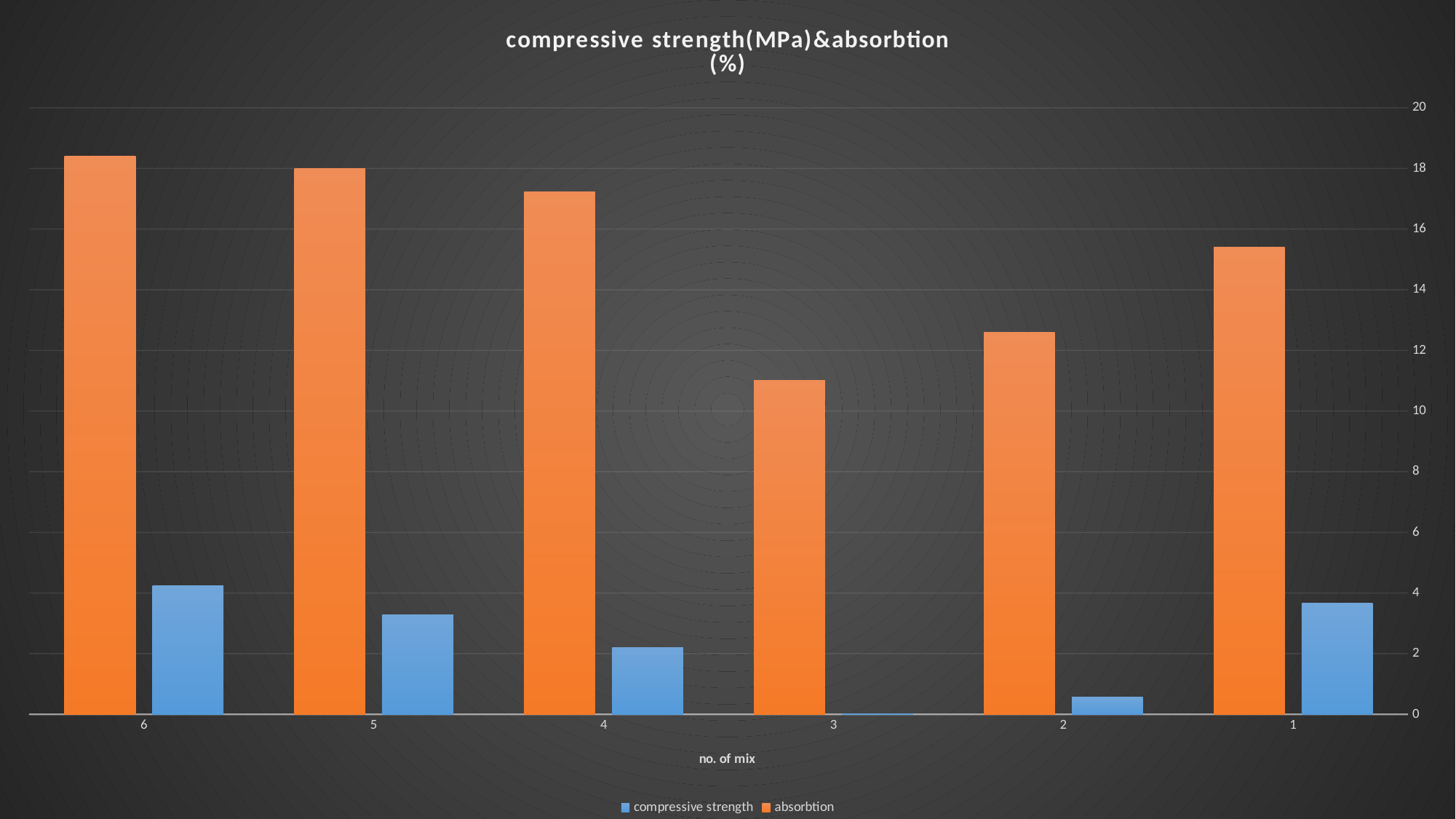
Is the absorbtion value for mix 3 greater or less than 12? less What kind of chart is shown on the slide? bar chart Is the compressive strength value for mix 4 greater or less than 3? less How many series does the legend list? 2 Which mix number has the highest compressive strength? 6 Which has the larger absorbtion value, mix 1 or mix 2? mix 1 Which mix number has the lowest compressive strength? 3 What is the title of the x axis? no. of mix Is the absorbtion value for mix 1 greater or less than 14? greater Which mix number has the lowest absorbtion? 3 Which mix number has the highest absorbtion? 6 How many mix numbers are shown on the x axis? 6